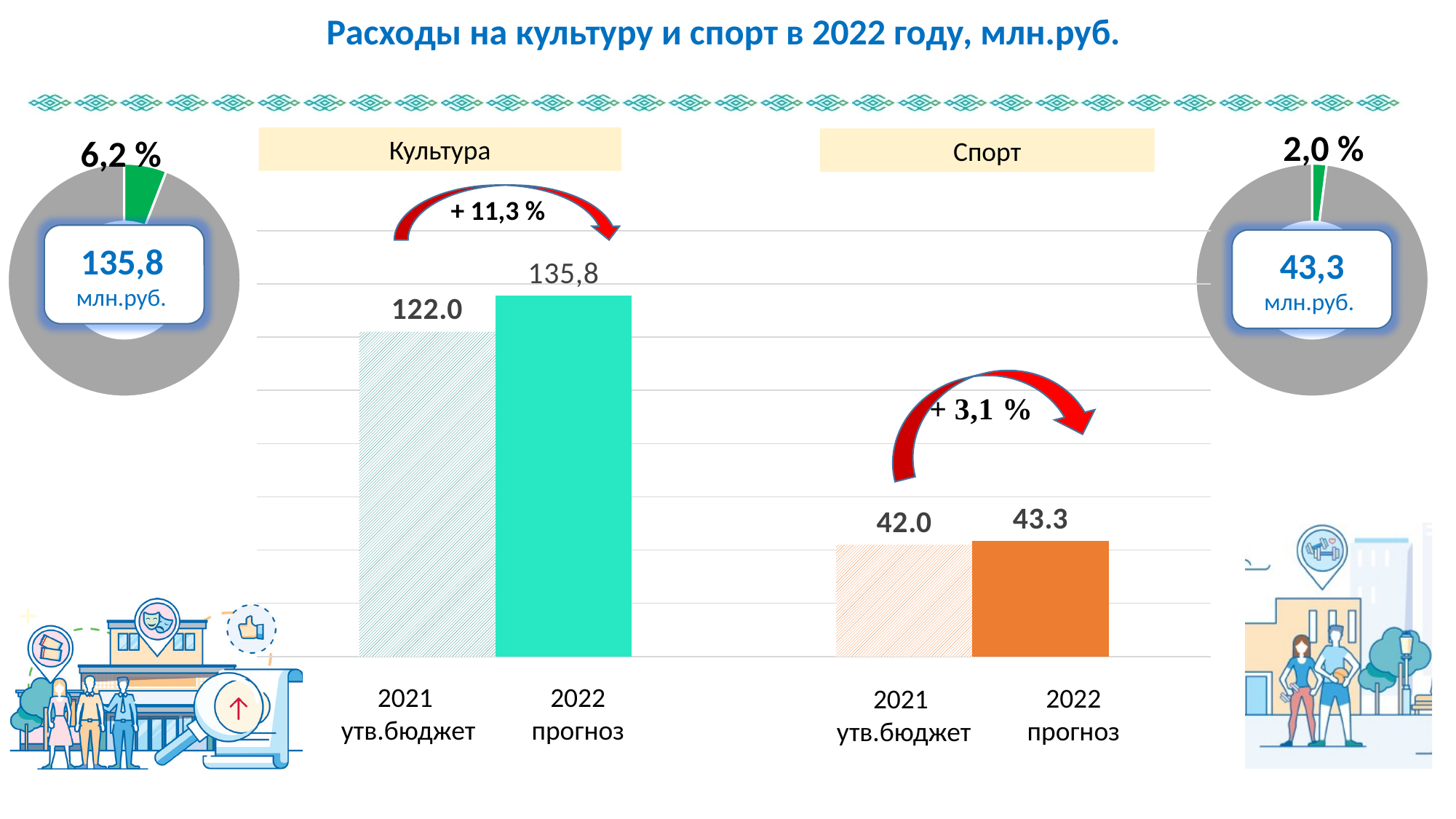
In the Спорт chart, what is the difference between the 2022 прогноз and 2021 утв.бюджет values? 1.3 How many bars are in the Спорт chart? 2 What kind of chart is the Культура chart? bar chart In the Спорт chart, what is the value for 2022 прогноз? 43.3 Is the 2022 прогноз value in the Культура chart larger or smaller than the 2022 прогноз value in the Спорт chart? larger What percentage change is shown by the arrow above the Культура chart? + 11,3 % In the Культура chart, what is the difference between the 2022 прогноз and 2021 утв.бюджет values? 13.8 In the Культура chart, what is the value for 2021 утв.бюджет? 122.0 In the Культура chart, what is the value for 2022 прогноз? 135,8 In the Культура chart, which category has the higher value? 2022 прогноз In the Спорт chart, what is the value for 2021 утв.бюджет? 42.0 In the Спорт chart, which category has the lower value? 2021 утв.бюджет